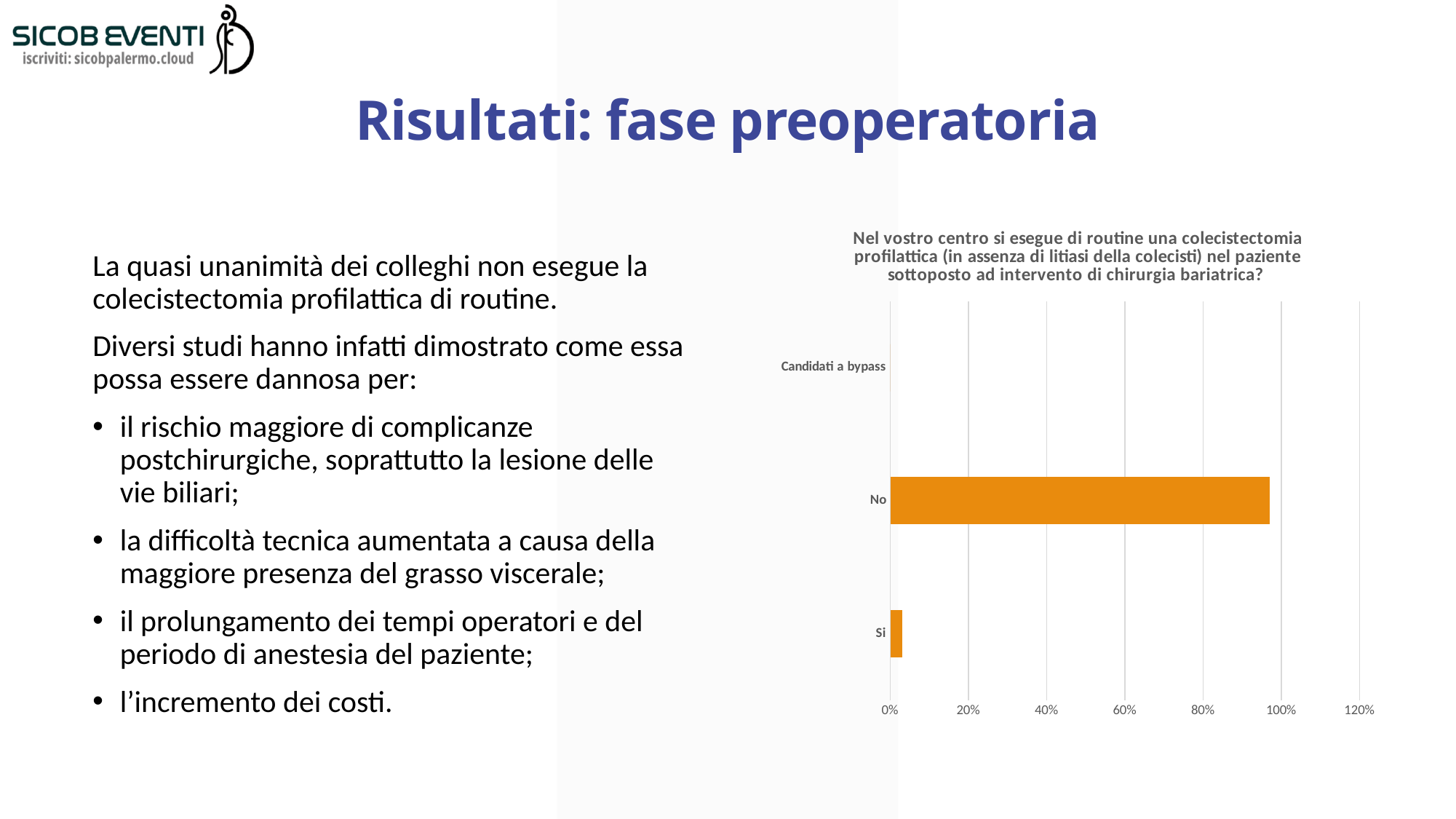
What kind of chart is shown on the slide? bar chart Is the value for Si greater or less than 20%? less What colour are the bars in the chart? orange Is the value for No greater or less than 80%? greater Which has the larger value, No or Si? No What is the highest tick value shown on the chart's horizontal axis? 120% Is the value for No greater or less than 100%? less How many categories are shown on the chart's vertical axis? 3 Which category has the lowest value in the chart? Candidati a bypass Which category has the highest value in the chart? No